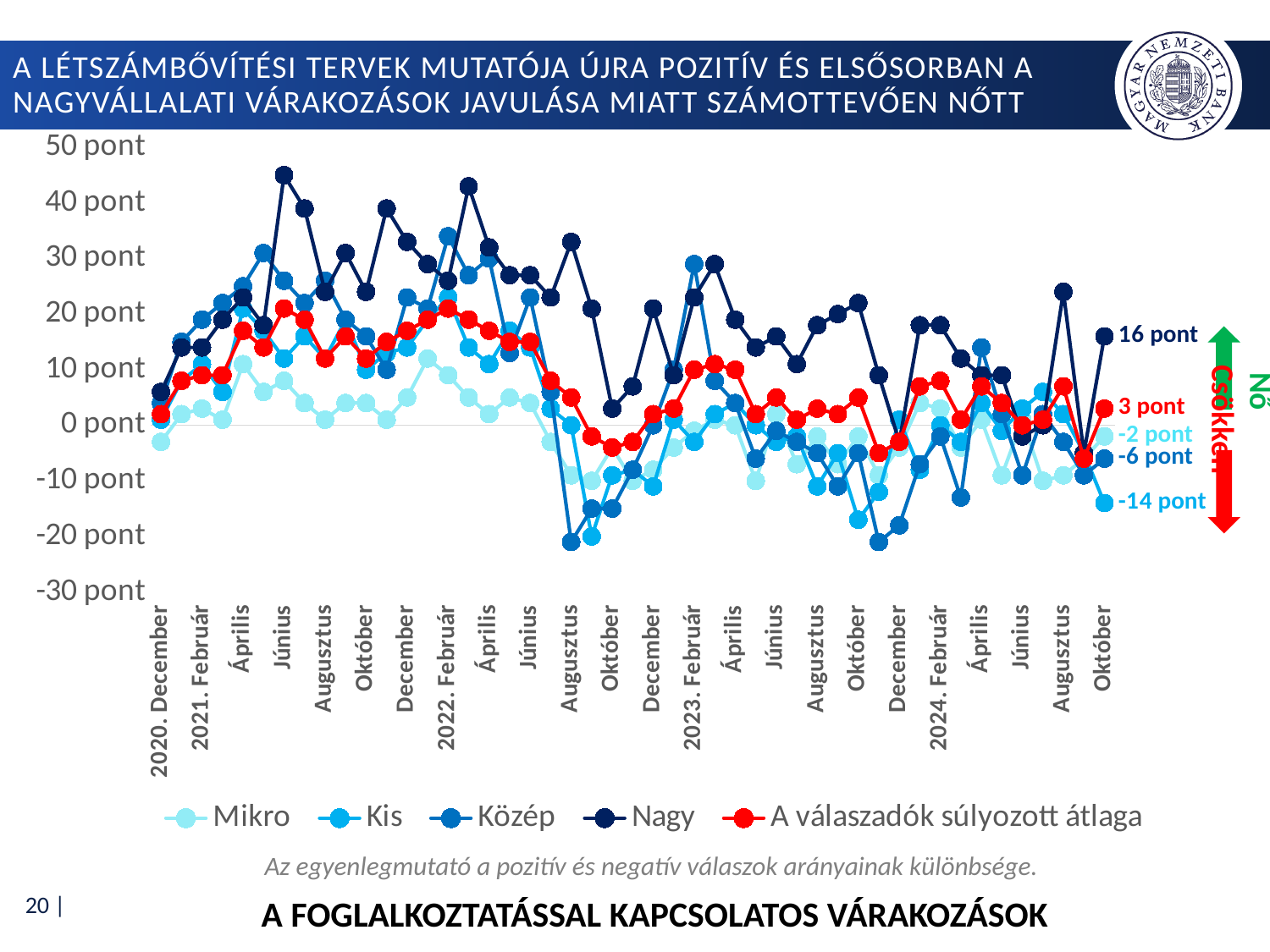
What is the value of the Mikro series at the last data point (2024 Október)? -2 pont At the last data point (2024 Október), which is larger: the Mikro value or the Közép value? Mikro What is the value of the Közép series at the last data point (2024 Október)? -6 pont How many series does the legend list? 5 Which series has the lowest value at the last data point (2024 Október)? Kis What is the value of the Nagy series at the last data point (2024 Október)? 16 pont Is the value of the Nagy series in 2021 Június greater or less than 40 pont? greater Which series has the highest value at the last data point (2024 Október)? Nagy What is the difference between the Nagy and Kis values at the last data point (2024 Október)? 30 pont What is the value of 'A válaszadók súlyozott átlaga' at the last data point (2024 Október)? 3 pont What is the value of the Kis series at the last data point (2024 Október)? -14 pont What kind of chart is shown on the slide? line chart